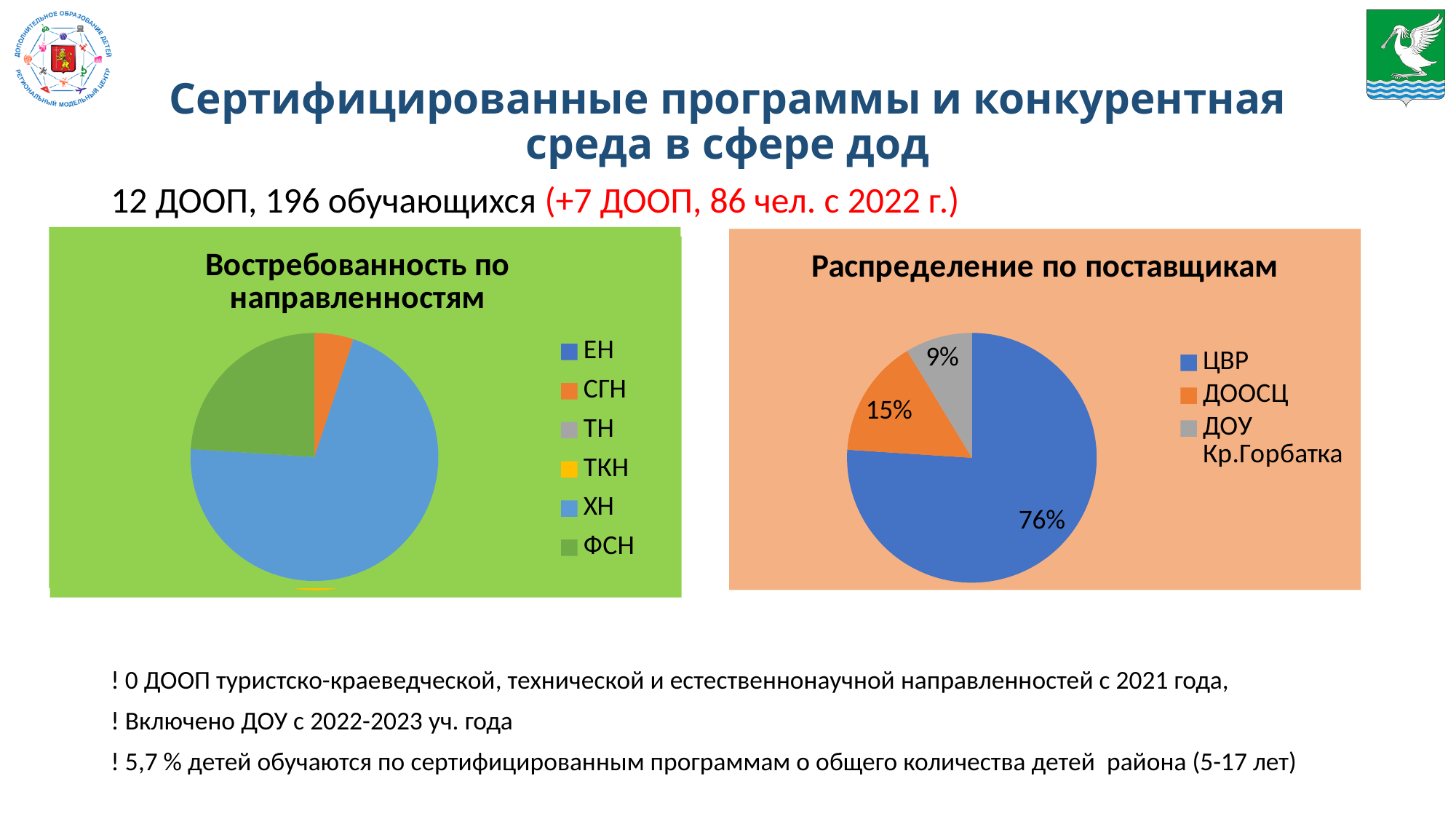
In the chart titled "Распределение по поставщикам", how many entries does the legend list? 3 In the chart titled "Распределение по поставщикам", which is larger: the share of ДООСЦ or the share of ДОУ Кр.Горбатка? ДООСЦ In the chart titled "Распределение по поставщикам", what is the difference between the shares of ЦВР and ДООСЦ? 61% In the chart titled "Распределение по поставщикам", which provider has the smallest share? ДОУ Кр.Горбатка In the chart titled "Распределение по поставщикам", which provider has the largest share? ЦВР In the chart titled "Распределение по поставщикам", what share does ДОУ Кр.Горбатка have? 9% What kind of chart is the one titled "Востребованность по направленностям"? Pie chart In the chart titled "Востребованность по направленностям", which category has the largest slice? ХН In the chart titled "Востребованность по направленностям", which is larger: the slice for ФСН or the slice for СГН? ФСН In the chart titled "Востребованность по направленностям", how many entries does the legend list? 6 In the chart titled "Распределение по поставщикам", what share does ЦВР have? 76% In the chart titled "Распределение по поставщикам", what share does ДООСЦ have? 15%